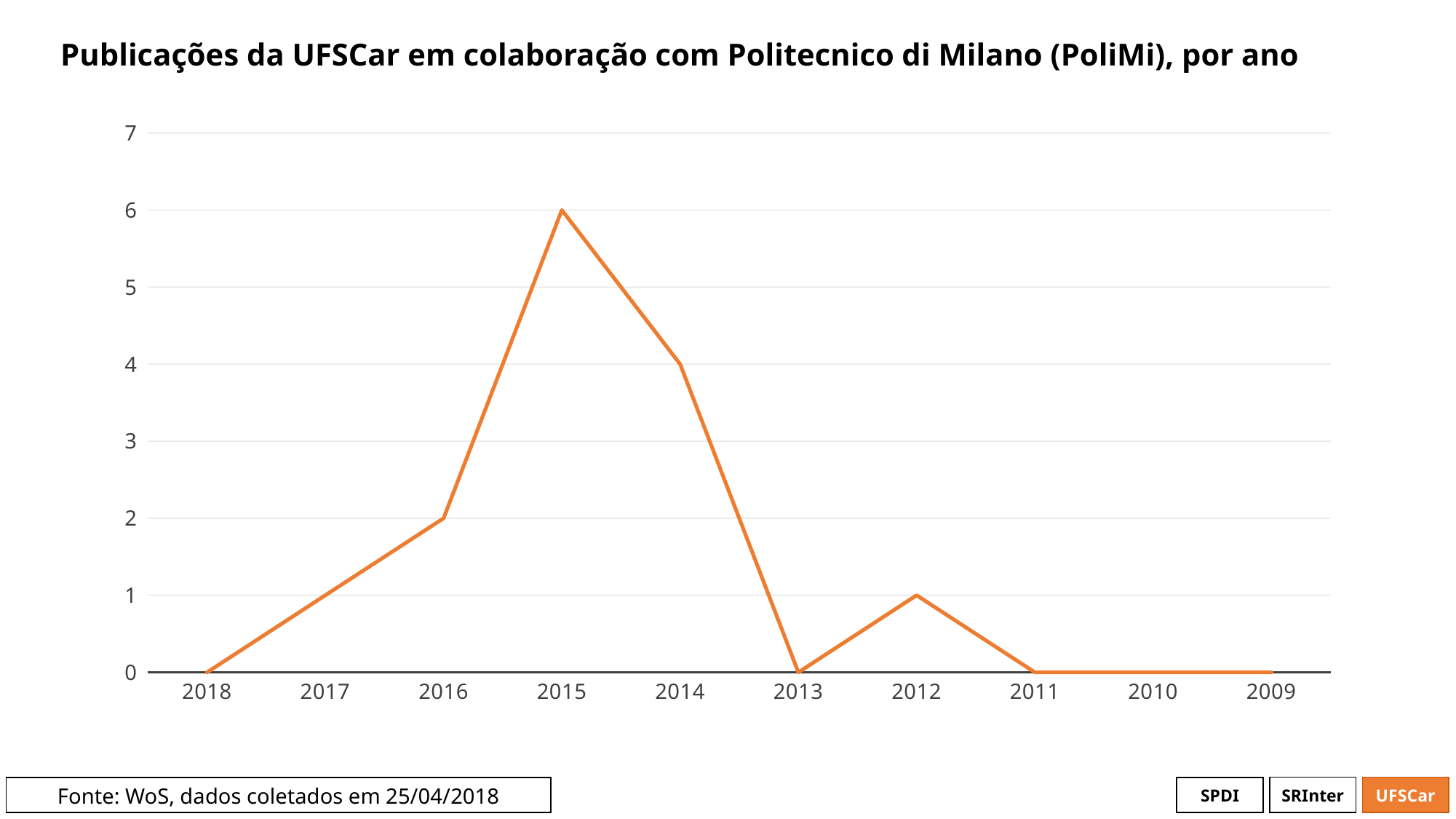
What is the title of the chart? Publicações da UFSCar em colaboração com Politecnico di Milano (PoliMi), por ano Which is larger, the value for 2016 or the value for 2012? 2016 What is the value for 2013? 0 What is the value for 2016? 2 What kind of chart is shown on the slide? line chart What is the value for 2014? 4 How many years are plotted on the x axis? 10 Is the value for 2015 greater or less than 5? greater Which year has the highest number of publications? 2015 What is the value for 2012? 1 What is the value for 2015? 6 What is the difference between the values for 2015 and 2014? 2